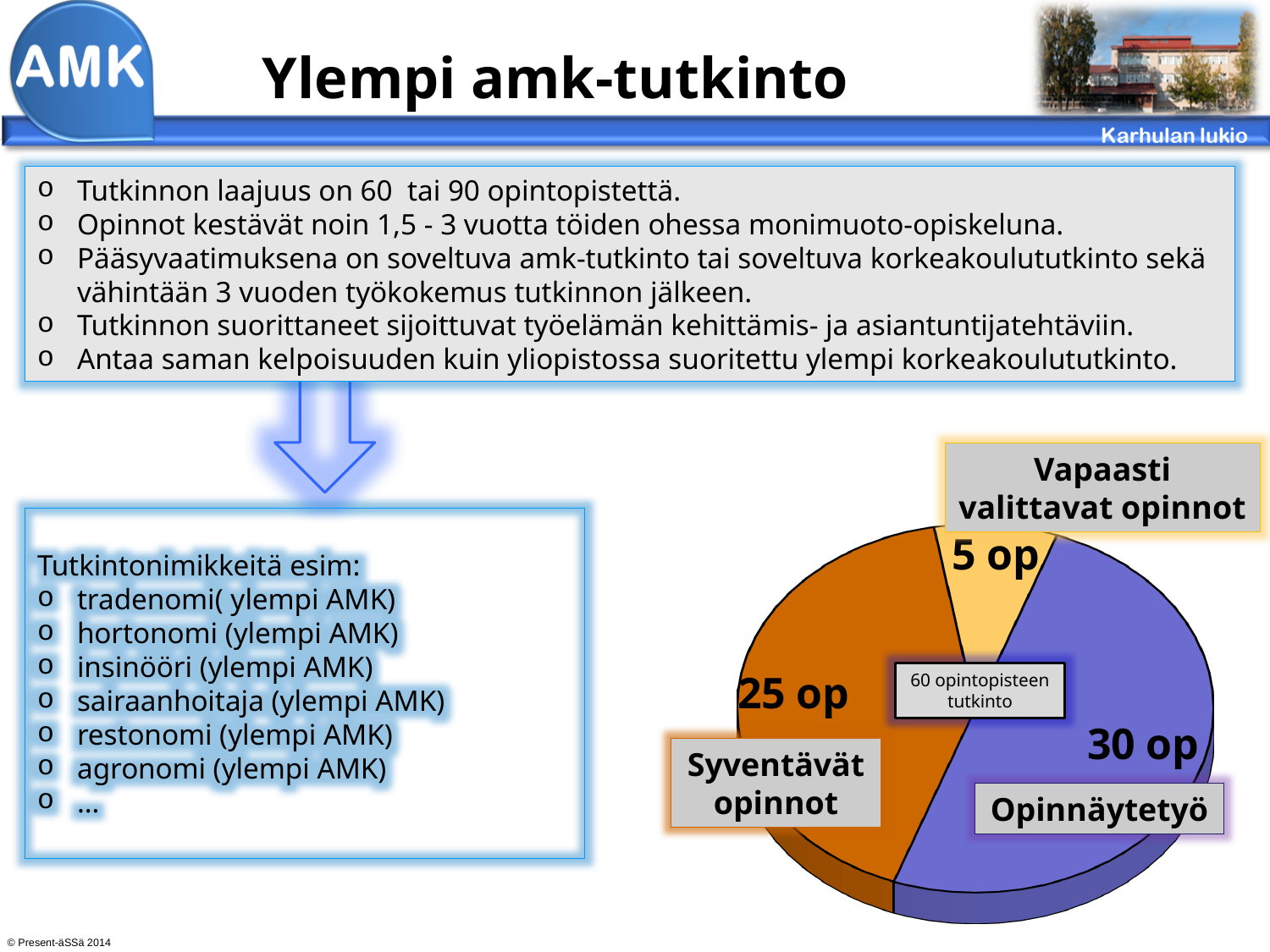
What share of the pie does Opinnäytetyö represent? 50% Which slice of the pie chart is the smallest? Vapaasti valittavat opinnot What is the value for Syventävät opinnot in the pie chart? 25 op Which slice of the pie chart is the largest? Opinnäytetyö What text is shown in the label at the centre of the pie chart? 60 opintopisteen tutkinto What is the total of all slices in the pie chart? 60 op What kind of chart is shown on the slide? pie chart How many slices does the pie chart have? 3 Which is larger in the pie chart, Syventävät opinnot or Vapaasti valittavat opinnot? Syventävät opinnot What is the value for Opinnäytetyö in the pie chart? 30 op What is the value for Vapaasti valittavat opinnot in the pie chart? 5 op What is the difference between Opinnäytetyö and Syventävät opinnot in the pie chart? 5 op